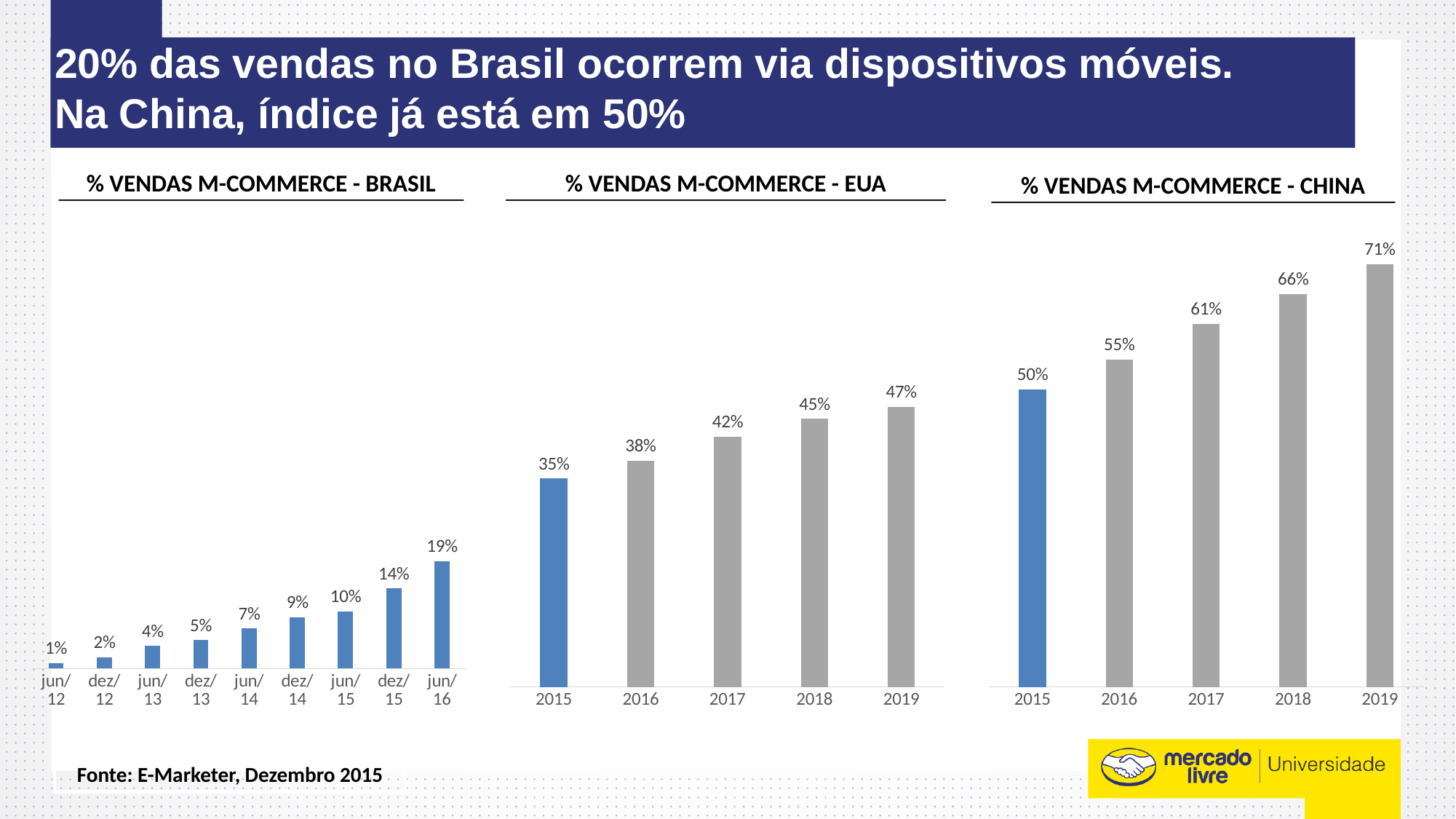
What kind of chart is the '% VENDAS M-COMMERCE - EUA' chart? Bar chart Which is larger: the 2015 value in the '% VENDAS M-COMMERCE - EUA' chart or the 2015 value in the '% VENDAS M-COMMERCE - CHINA' chart? China (50%) In the '% VENDAS M-COMMERCE - CHINA' chart, do the values rise or fall from 2015 to 2019? Rise In the '% VENDAS M-COMMERCE - BRASIL' chart, what is the value for jun/16? 19% In the '% VENDAS M-COMMERCE - EUA' chart, what is the difference between the 2019 and 2015 values? 12% How many periods are shown on the x axis of the '% VENDAS M-COMMERCE - BRASIL' chart? 9 In the '% VENDAS M-COMMERCE - CHINA' chart, which year has the lowest value? 2015 In the '% VENDAS M-COMMERCE - BRASIL' chart, what is the value for dez/14? 9% In the '% VENDAS M-COMMERCE - BRASIL' chart, which period has the highest value? jun/16 In the '% VENDAS M-COMMERCE - CHINA' chart, what is the value for 2019? 71% In the '% VENDAS M-COMMERCE - EUA' chart, what is the value for 2017? 42% In the '% VENDAS M-COMMERCE - CHINA' chart, what is the difference between the 2018 and 2016 values? 11%